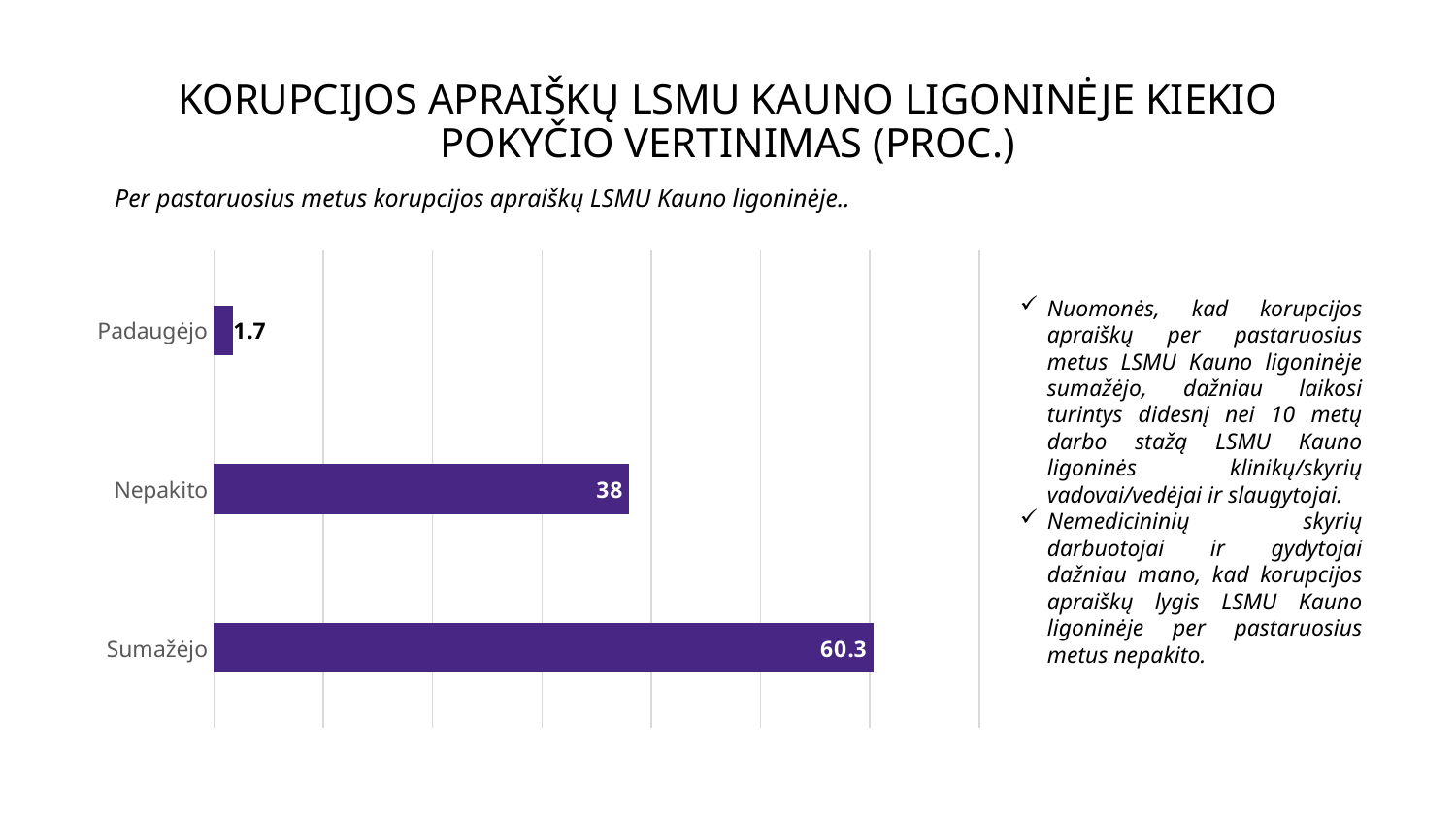
What is the value for Sumažėjo? 60.3 What is the difference between the values for Nepakito and Padaugėjo? 36.3 Which category has the highest value? Sumažėjo What is the difference between the values for Sumažėjo and Nepakito? 22.3 What is the total of the three values shown in the chart? 100 What is the value for Nepakito? 38 What colour are the bars in the chart? Purple What kind of chart is shown on the slide? Bar chart How many categories are shown in the chart? 3 Which is larger, the value for Nepakito or the value for Padaugėjo? Nepakito Which category has the lowest value? Padaugėjo What is the value for Padaugėjo? 1.7